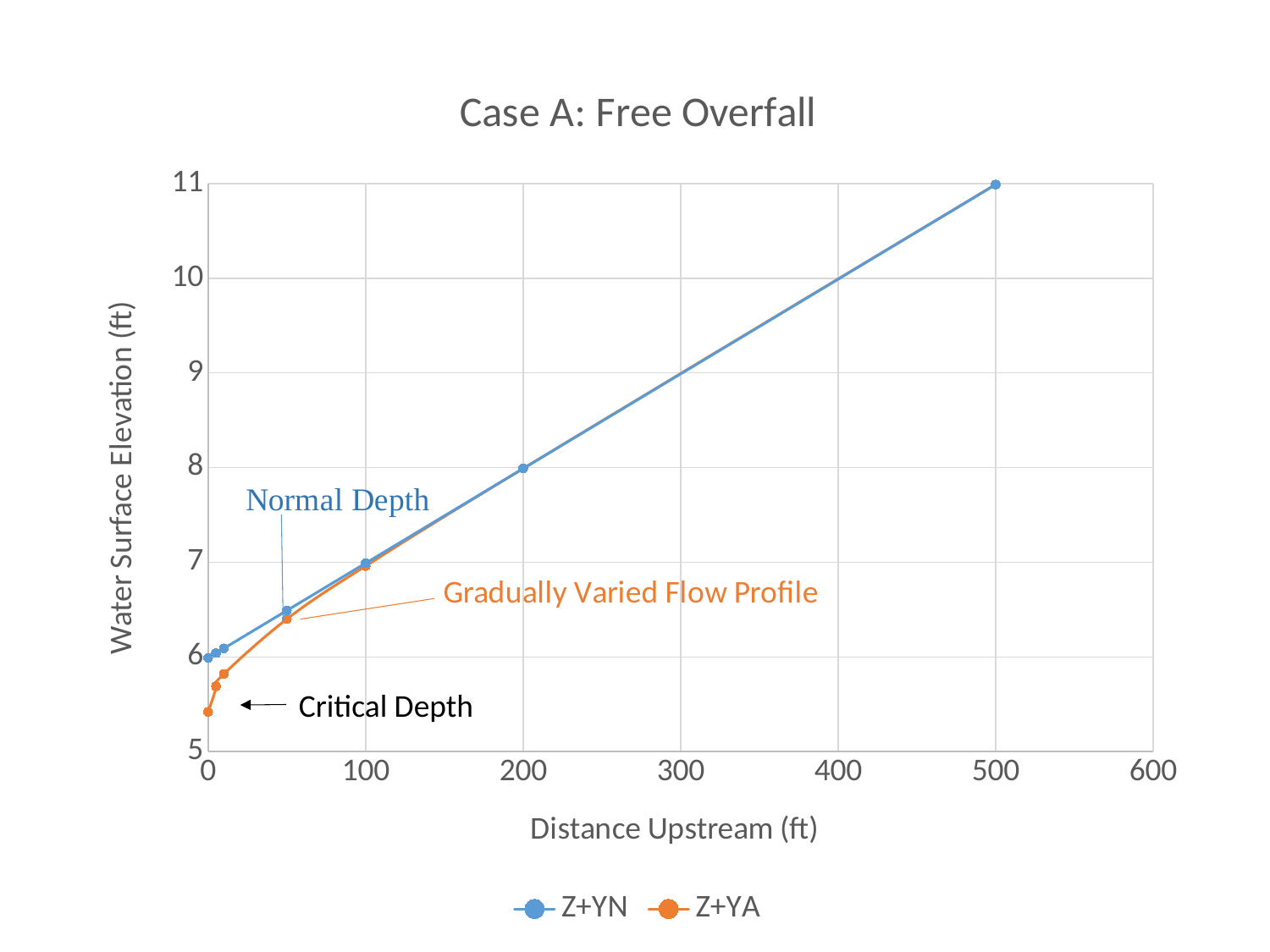
Is the value of the Z+YN series at 200 ft upstream greater or less than 7? greater Is the value of the Z+YA series at 0 ft upstream greater or less than 6? less How many series does the legend list? 2 Is the value of the Z+YN series at 500 ft upstream greater or less than 10? greater What is the label of the vertical axis? Water Surface Elevation (ft) What is the title of the chart? Case A: Free Overfall Which series is drawn in orange? Z+YA What kind of chart is shown on the slide? line chart At 50 ft upstream, which series has the higher water surface elevation, Z+YN or Z+YA? Z+YN Does the Z+YN series rise or fall as distance upstream increases? rise